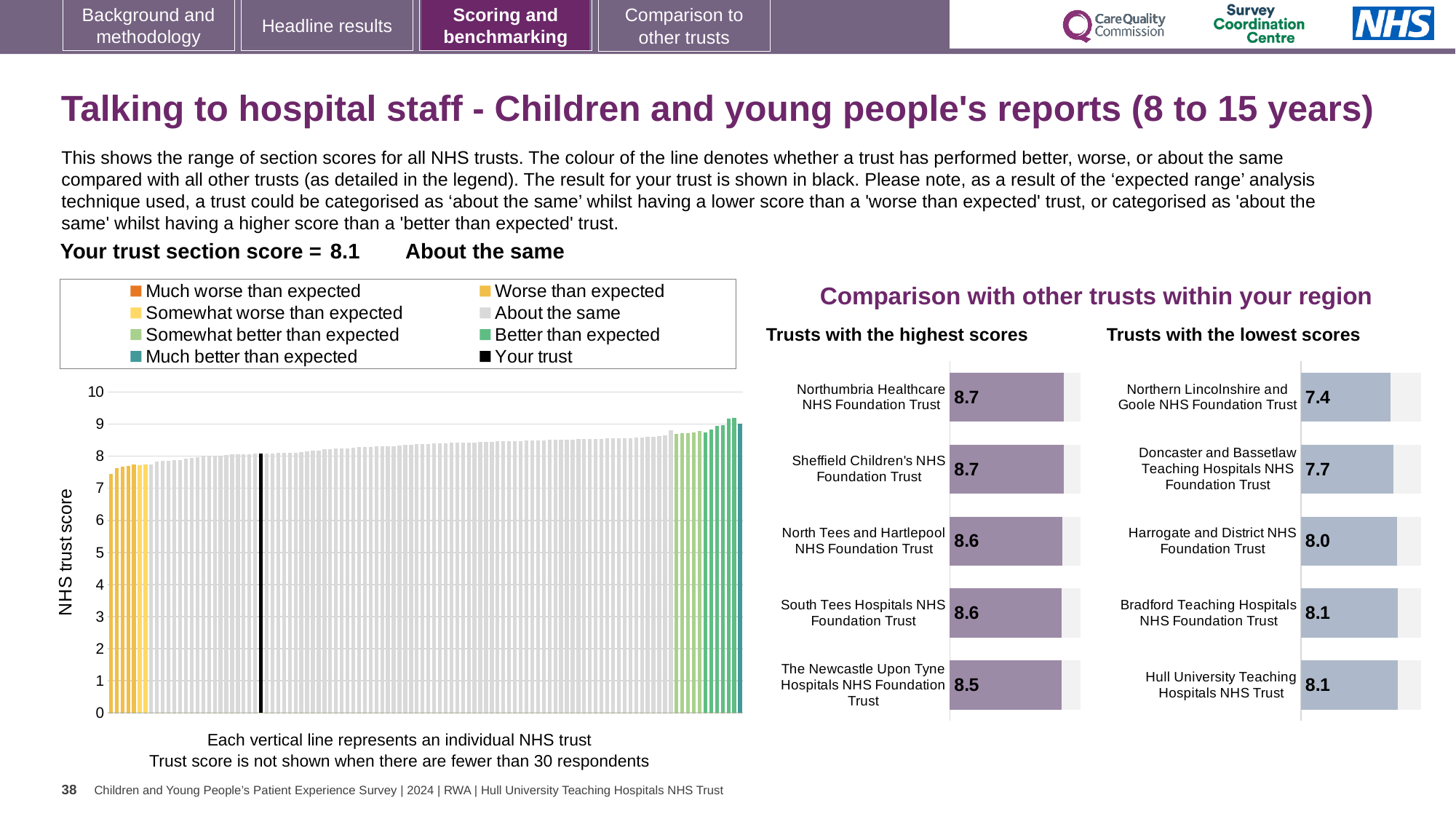
In the 'Trusts with the lowest scores' chart, which has the higher score: Doncaster and Bassetlaw Teaching Hospitals NHS Foundation Trust or Harrogate and District NHS Foundation Trust? Harrogate and District NHS Foundation Trust In the 'Trusts with the lowest scores' chart, what is the score for Harrogate and District NHS Foundation Trust? 8.0 In the 'Trusts with the highest scores' chart, what is the score for Northumbria Healthcare NHS Foundation Trust? 8.7 In the 'Trusts with the highest scores' chart, which trust has the lowest score? The Newcastle Upon Tyne Hospitals NHS Foundation Trust In the large chart on the left, do the trust scores rise or fall from left to right? Rise How many entries does the legend of the large chart on the left list? 8 What kind of chart is the large chart on the left showing NHS trust scores? Bar chart In the 'Trusts with the lowest scores' chart, which trust has the lowest score? Northern Lincolnshire and Goole NHS Foundation Trust In the 'Trusts with the lowest scores' chart, what is the difference between the scores of Hull University Teaching Hospitals NHS Trust and Northern Lincolnshire and Goole NHS Foundation Trust? 0.7 How many trusts are shown in the 'Trusts with the highest scores' chart? 5 In the 'Trusts with the highest scores' chart, what is the score for The Newcastle Upon Tyne Hospitals NHS Foundation Trust? 8.5 In the 'Trusts with the lowest scores' chart, what is the score for Northern Lincolnshire and Goole NHS Foundation Trust? 7.4